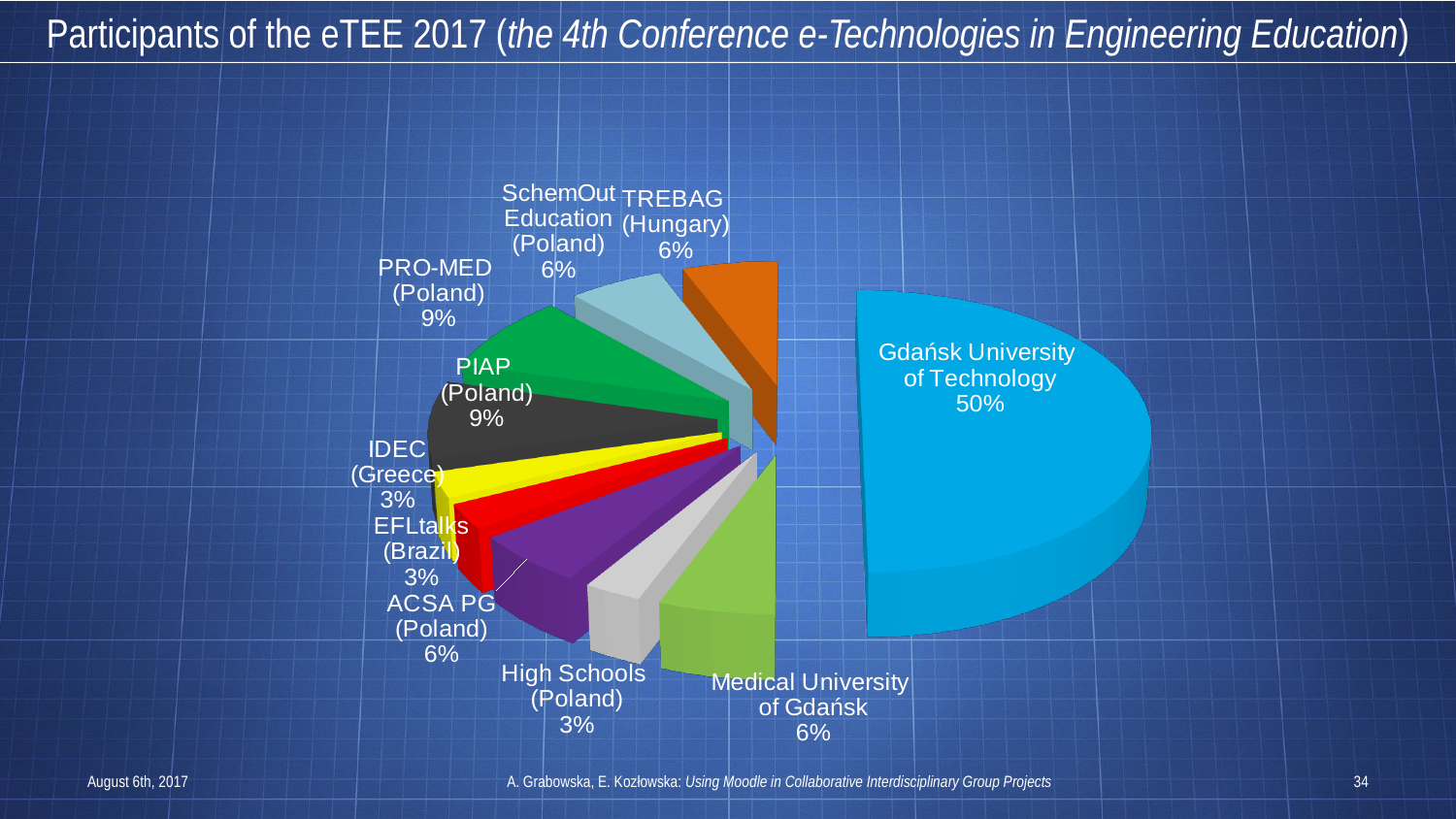
Which institution has the largest slice of the pie? Gdańsk University of Technology What is the combined share of Medical University of Gdańsk and ACSA PG (Poland)? 12% What kind of chart is shown on the slide? Pie chart What percentage of participants is shown for EFLtalks (Brazil)? 3% Which is larger, the share for PRO-MED (Poland) or the share for SchemOut Education (Poland)? PRO-MED (Poland) What percentage of participants is shown for High Schools (Poland)? 3% What percentage of participants is shown for PIAP (Poland)? 9% How many slices does the pie chart have? 10 What percentage of participants is shown for TREBAG (Hungary)? 6% By how many percentage points does the share of Gdańsk University of Technology exceed the share of PIAP (Poland)? 41 percentage points What share of the eTEE 2017 participants came from Gdańsk University of Technology? 50% What is the title of the slide containing the pie chart? Participants of the eTEE 2017 (the 4th Conference e-Technologies in Engineering Education)